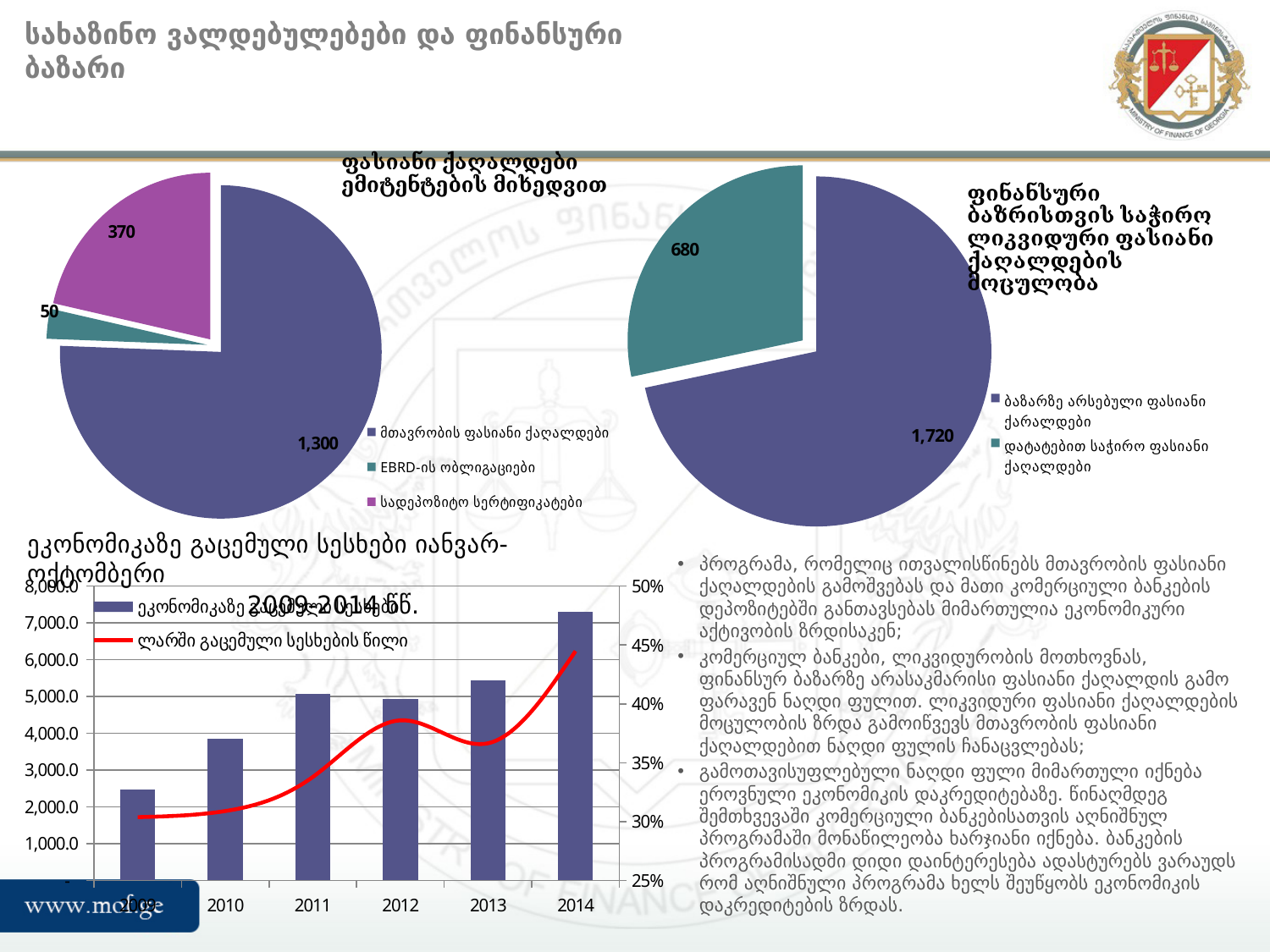
In the bottom-left chart, is the bar value for 2009 greater or less than 3,000.0? less In the top-right pie chart, which slice is smaller? დატატებით საჭირო ფასიანი ქაღალდები In the top-left pie chart, which category has the largest slice? მთავრობის ფასიანი ქაღალდები In the top-right pie chart, what is the value for ბაზარზე არსებული ფასიანი ქარალდები? 1,720 How many slices does the top-left pie chart have? 3 In the top-right pie chart, what is the total of the two slices? 2,400 In the top-right pie chart, what is the value for დატატებით საჭირო ფასიანი ქაღალდები? 680 In the bottom-left chart, which year has the tallest bar? 2014 How many series does the legend of the bottom-left chart list? 2 In the top-left pie chart (ფასიანი ქაღალდები ემიტენტების მიხედვით), what is the value for მთავრობის ფასიანი ქაღალდები? 1,300 In the top-left pie chart, what is the difference between სადეპოზიტო სერტიფიკატები and EBRD-ის ობლიგაციები? 320 In the top-left pie chart, what is the value for EBRD-ის ობლიგაციები? 50